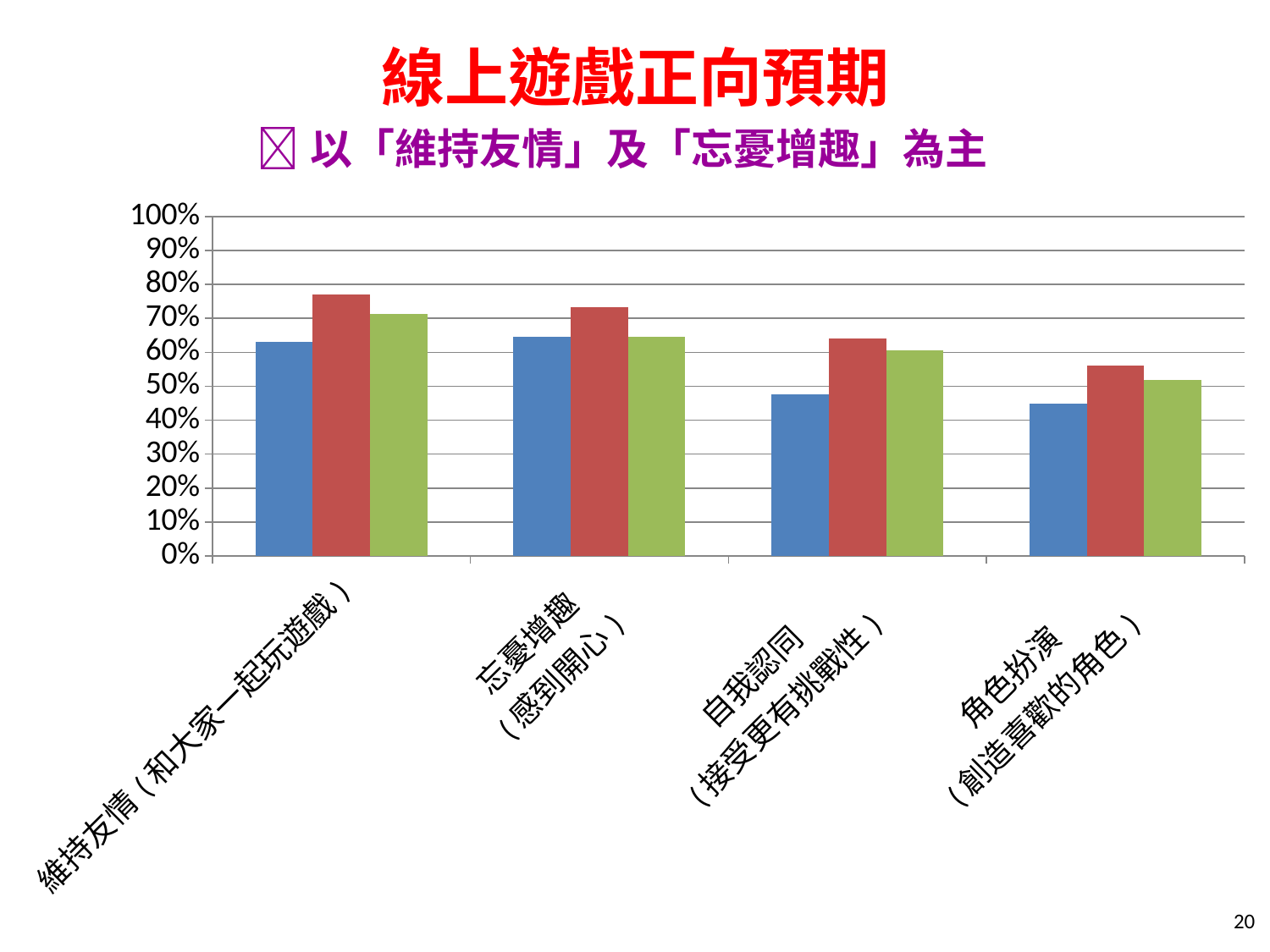
What kind of chart is shown on the slide? bar chart What is the main title of the slide above the chart? 線上遊戲正向預期 Is the blue bar for 角色扮演（創造喜歡的角色） greater or less than 50%? less Which category has the lowest blue bar? 角色扮演（創造喜歡的角色） Do the red bars generally rise or fall moving from left to right across the categories? fall Is the red bar for 維持友情（和大家一起玩遊戲） greater or less than 70%? greater How many categories are shown on the x axis of the chart? 4 Is the blue bar for 自我認同（接受更有挑戰性） greater or less than 50%? less How many bars are plotted for each category in the chart? 3 Which category has the highest red bar? 維持友情（和大家一起玩遊戲） Within the category 自我認同（接受更有挑戰性）, which bar is taller, the blue bar or the red bar? the red bar